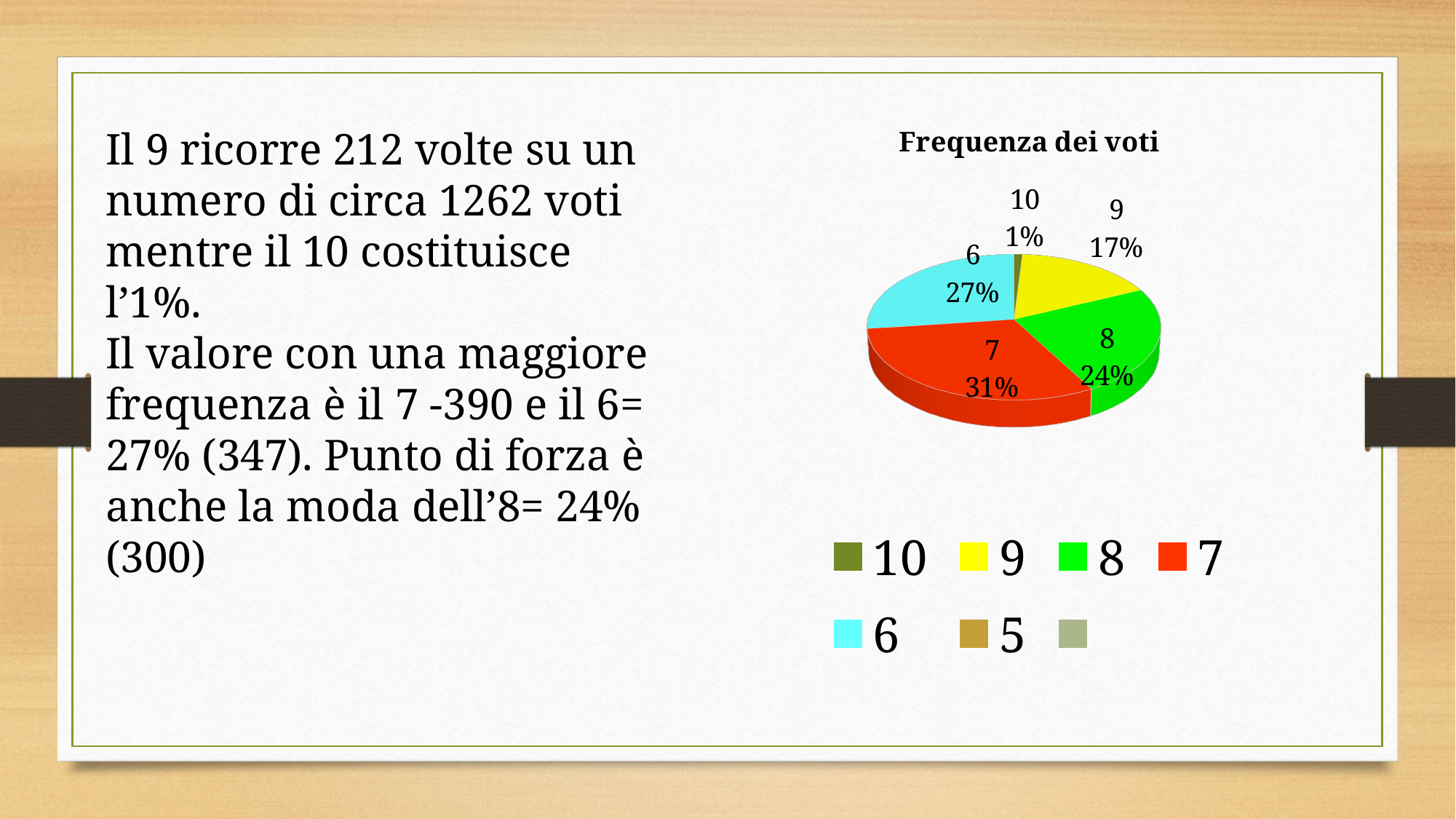
What percentage of the pie does the slice for 7 represent? 31% Which category has the largest slice of the pie? 7 What is the difference in percentage points between the slices for 7 and 9? 14 What percentage of the pie does the slice for 9 represent? 17% What percentage of the pie does the slice for 8 represent? 24% What is the title of the chart? Frequenza dei voti Which slice is larger, the one for 6 or the one for 8? 6 How many entries does the legend list? 7 Which category has the smallest slice of the pie? 10 What kind of chart is shown on the slide? pie chart